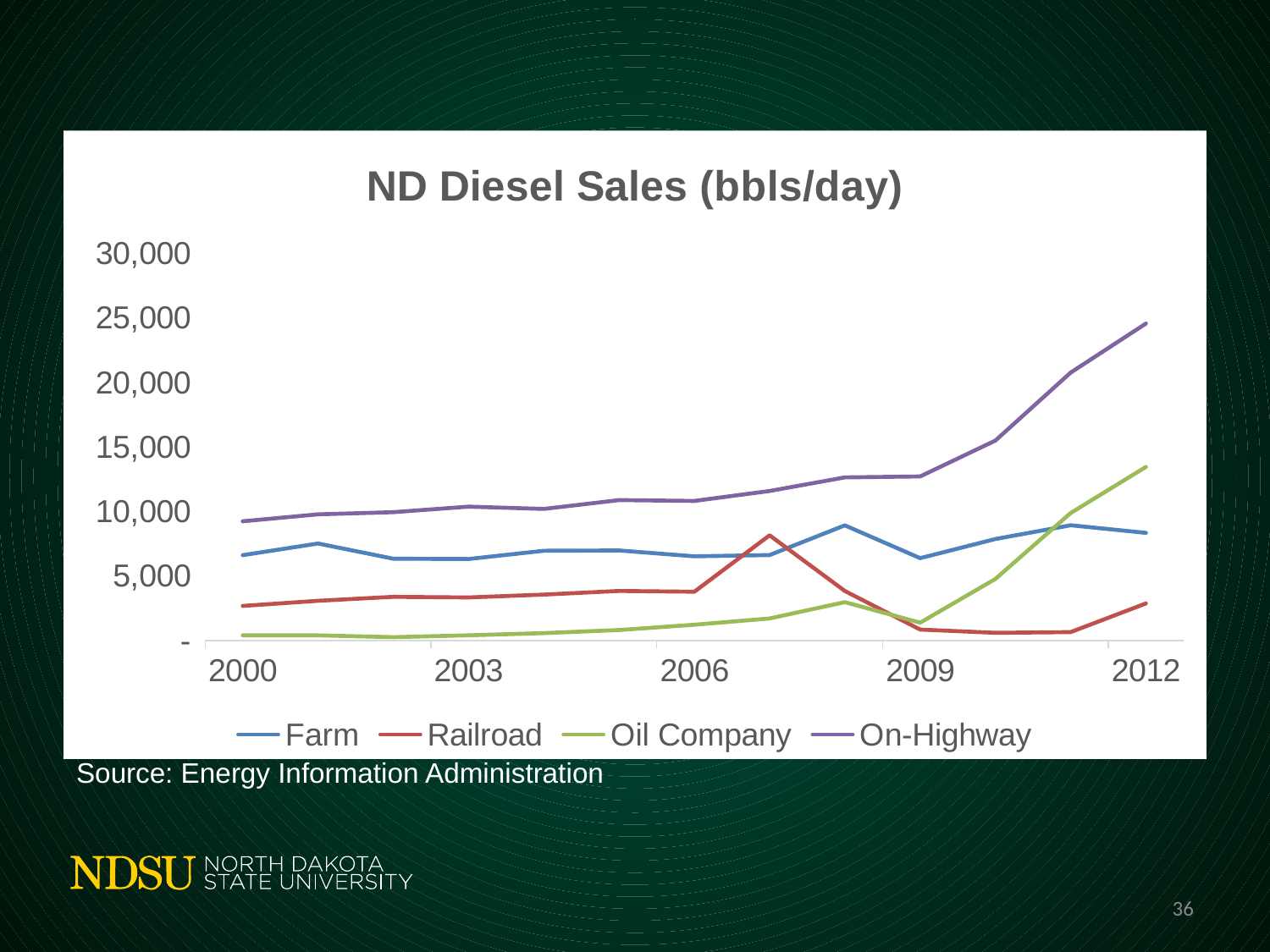
Is the value for Oil Company in 2000 greater or less than 5,000? less Which series is lowest in 2000? Oil Company What kind of chart is shown on the slide? Line chart Which is larger in 2012, Oil Company or Farm? Oil Company Is the value for Farm in 2000 greater or less than 5,000? greater Does the On-Highway series rise or fall from 2000 to 2012? Rise Is the value for Oil Company in 2012 greater or less than 10,000? greater How many series does the legend list? 4 Which series is lowest in 2012? Railroad What is the title of the chart? ND Diesel Sales (bbls/day) Which series is highest in 2012? On-Highway